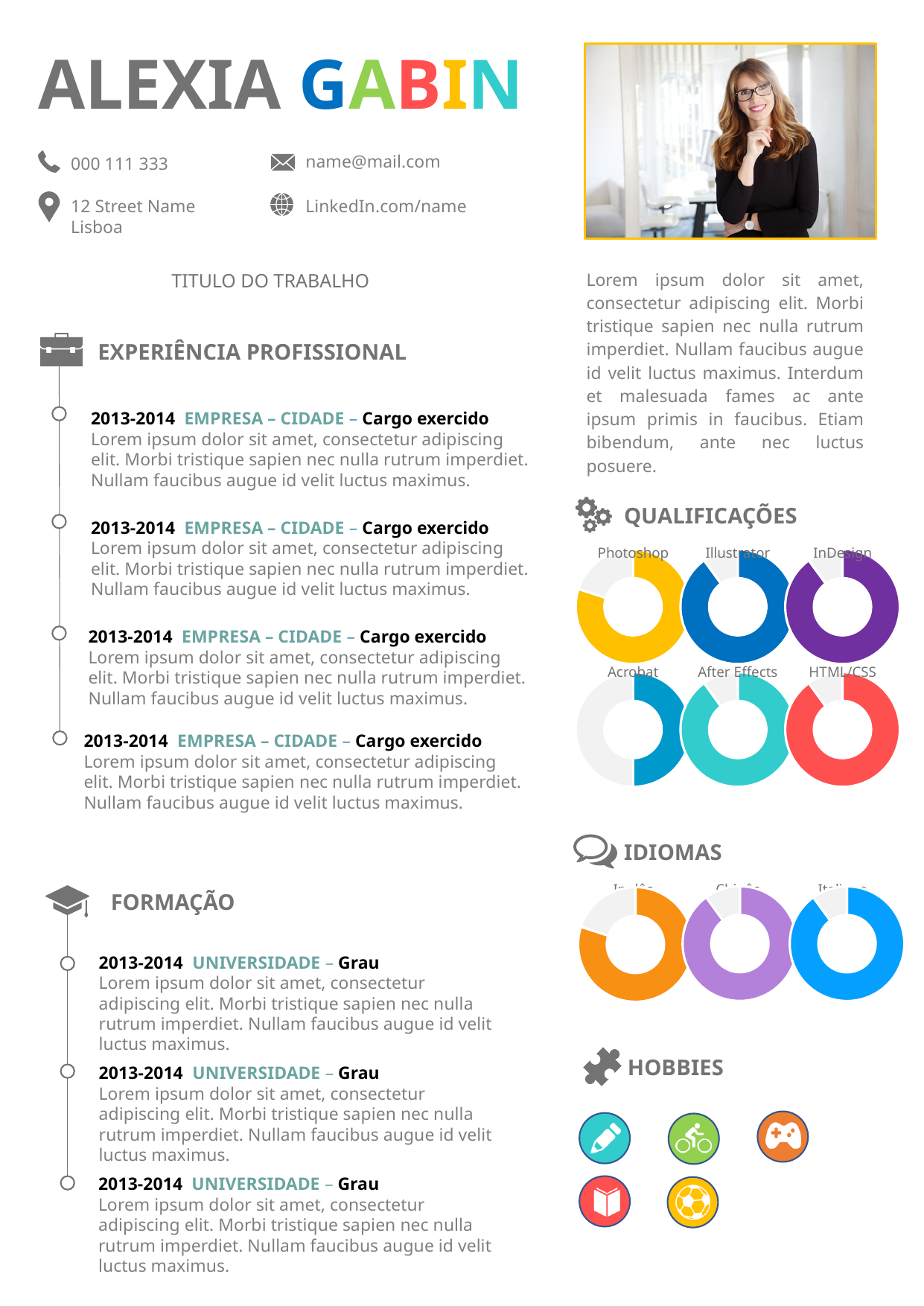
In the Qualificações section, which has a larger filled portion: Acrobat or HTML/CSS? HTML/CSS What kind of chart is used to show each skill in the Qualificações section? donut (pie) chart In the Qualificações section, which has a larger filled portion: Acrobat or Illustrator? Illustrator How many donut charts are shown in the Idiomas section? 3 In the Qualificações section, what colour is the Photoshop donut? yellow How many donut charts are shown in the Qualificações section? 6 In the Qualificações section, which skill has the smallest filled portion of its donut? Acrobat In the Qualificações section, what colour is the HTML/CSS donut? red